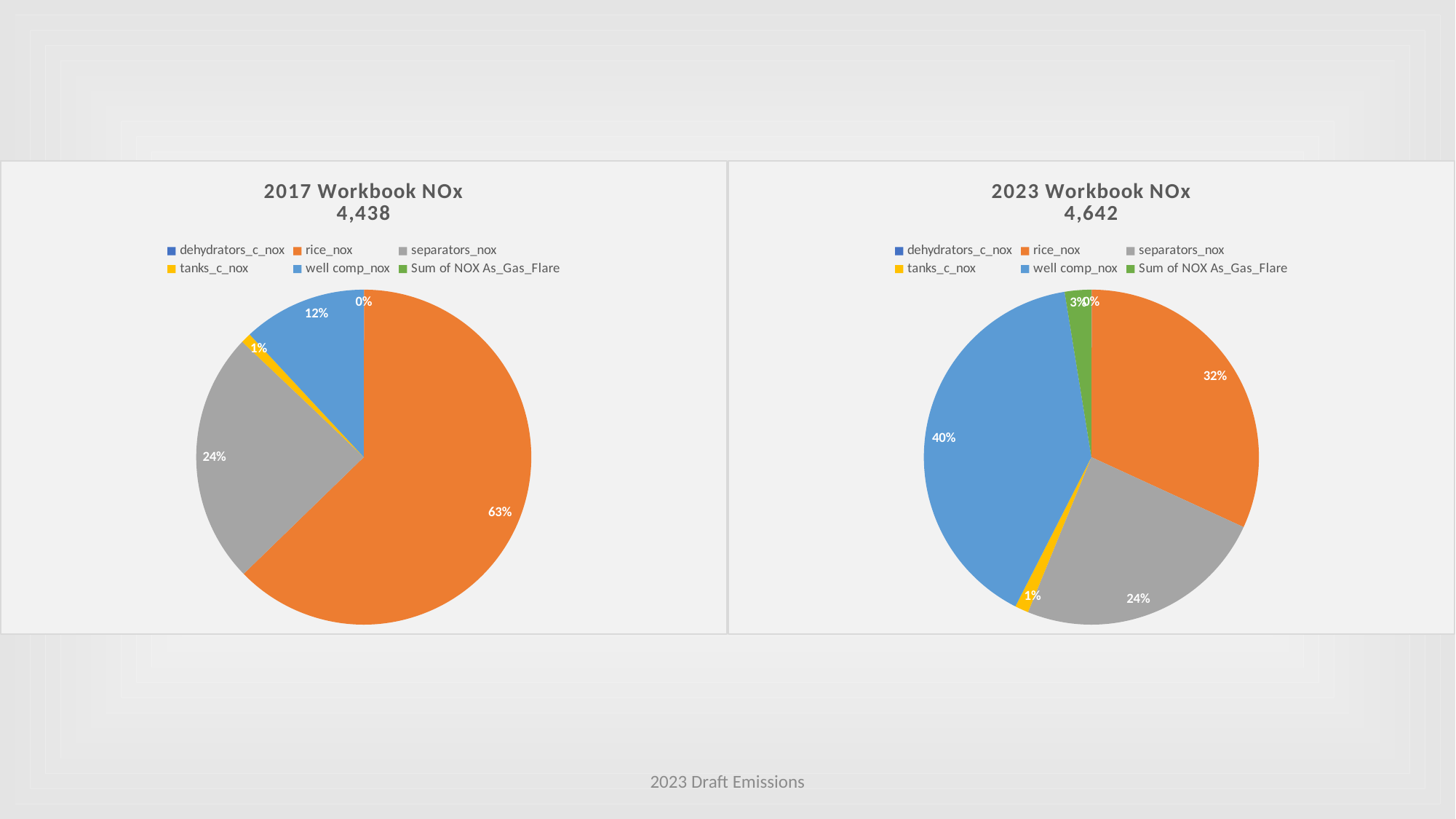
In the "2017 Workbook NOx" chart, what share of the pie is separators_nox? 24% In the "2023 Workbook NOx" chart, what share of the pie is Sum of NOX As_Gas_Flare? 3% In the "2023 Workbook NOx" chart, what share of the pie is rice_nox? 32% What total value is shown under the title of the "2023 Workbook NOx" chart? 4,642 In the "2023 Workbook NOx" chart, which category has the largest slice? well comp_nox In the "2017 Workbook NOx" chart, which category has the largest slice? rice_nox In the "2023 Workbook NOx" chart, what is the difference in percentage points between well comp_nox and rice_nox? 8 What type of chart is the "2017 Workbook NOx" chart? pie chart How many entries does the legend of the "2017 Workbook NOx" chart list? 6